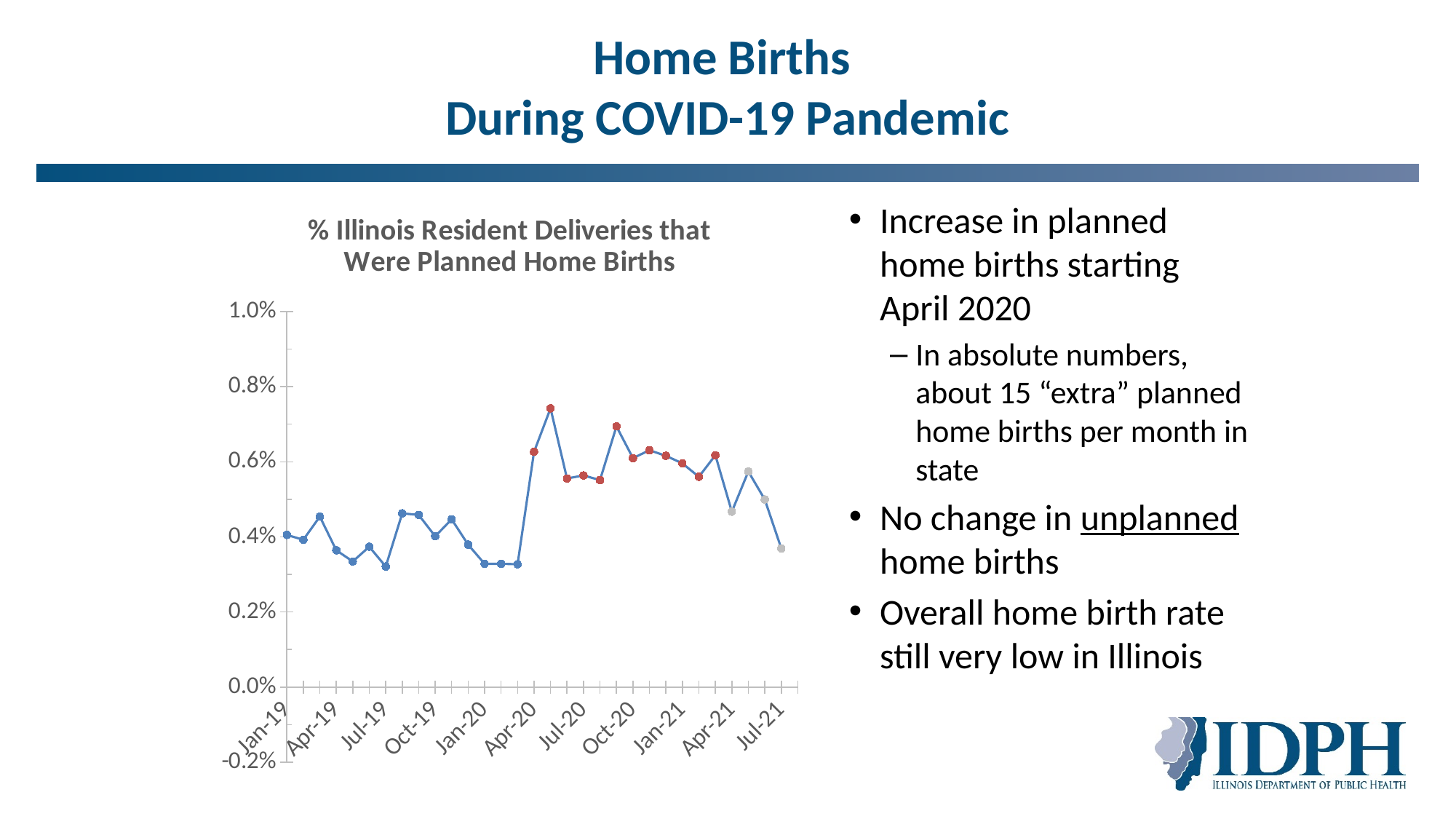
Which month has the highest value on the chart? May-20 Is the value for Apr-19 greater or less than 0.6%? less What is the title of the chart? % Illinois Resident Deliveries that Were Planned Home Births Which is larger, the value for Jul-19 or the value for Oct-19? Oct-19 Is the highest value on the chart greater or less than 0.8%? less Is the value for May-20 greater or less than 0.6%? greater What kind of chart is shown on the slide? line chart Which is larger, the value for Jan-19 or the value for May-20? May-20 Between Apr-21 and Jul-21, does the value rise or fall overall? fall What is the highest tick value shown on the y axis? 1.0%